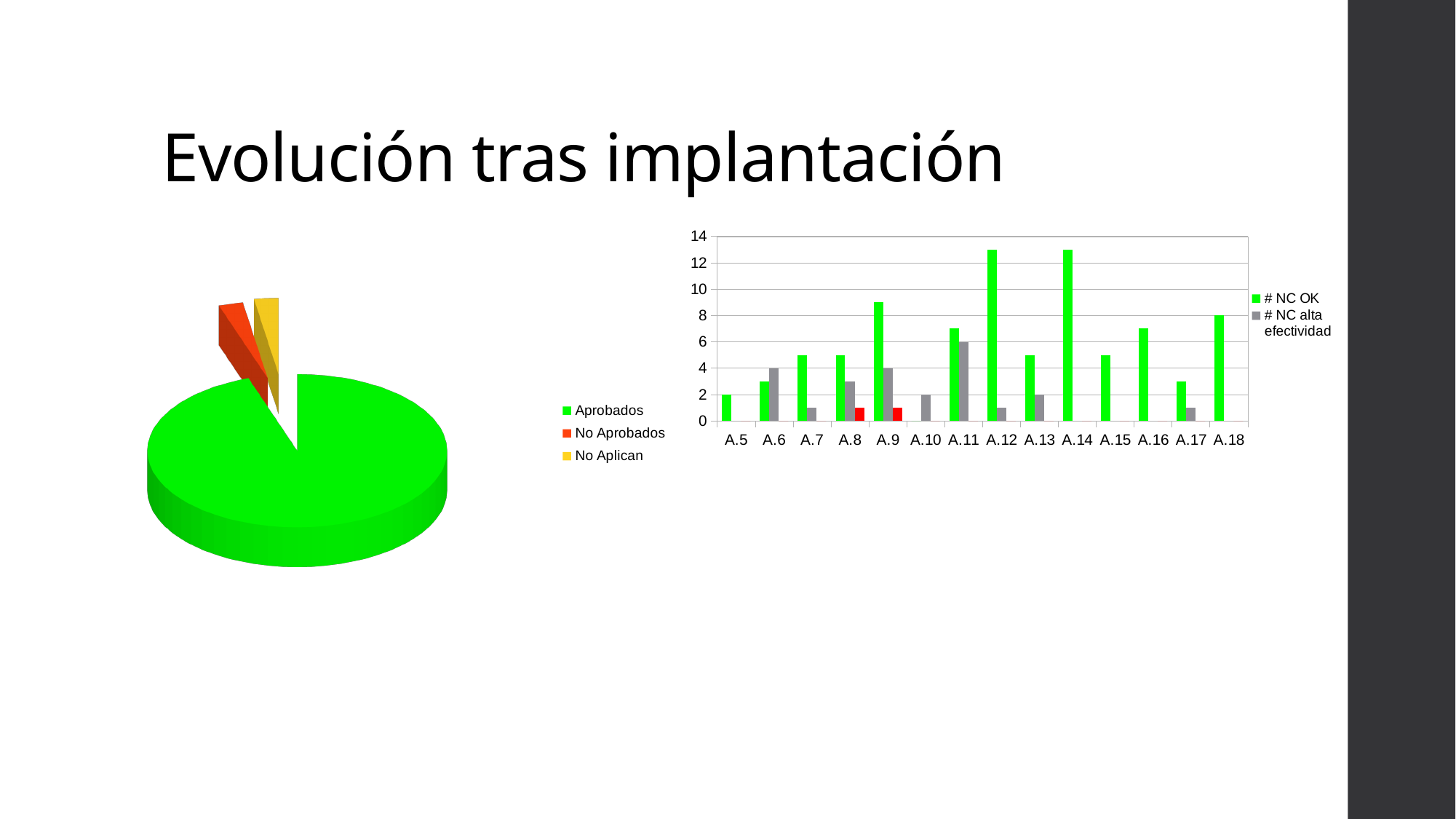
On the bar chart on the right, what is the value of # NC alta efectividad for A.6? 4 On the bar chart on the right, what is the value of # NC alta efectividad for A.11? 6 On the bar chart on the right, what is the value of # NC OK for A.18? 8 On the pie chart on the left, which category has the largest slice? Aprobados On the bar chart on the right, is the value of # NC OK for A.12 greater or less than 12? greater On the bar chart on the right, which is larger: # NC alta efectividad for A.11 or # NC alta efectividad for A.12? A.11 On the bar chart on the right, what is the value of # NC OK for A.5? 2 How many series does the legend of the bar chart on the right list? 2 On the bar chart on the right, what is the difference between # NC OK for A.18 and # NC OK for A.5? 6 On the bar chart on the right, is the value of # NC OK for A.17 greater or less than 4? less On the bar chart on the right, which is larger: # NC OK for A.9 or # NC OK for A.5? A.9 How many categories are shown on the x axis of the bar chart on the right? 14